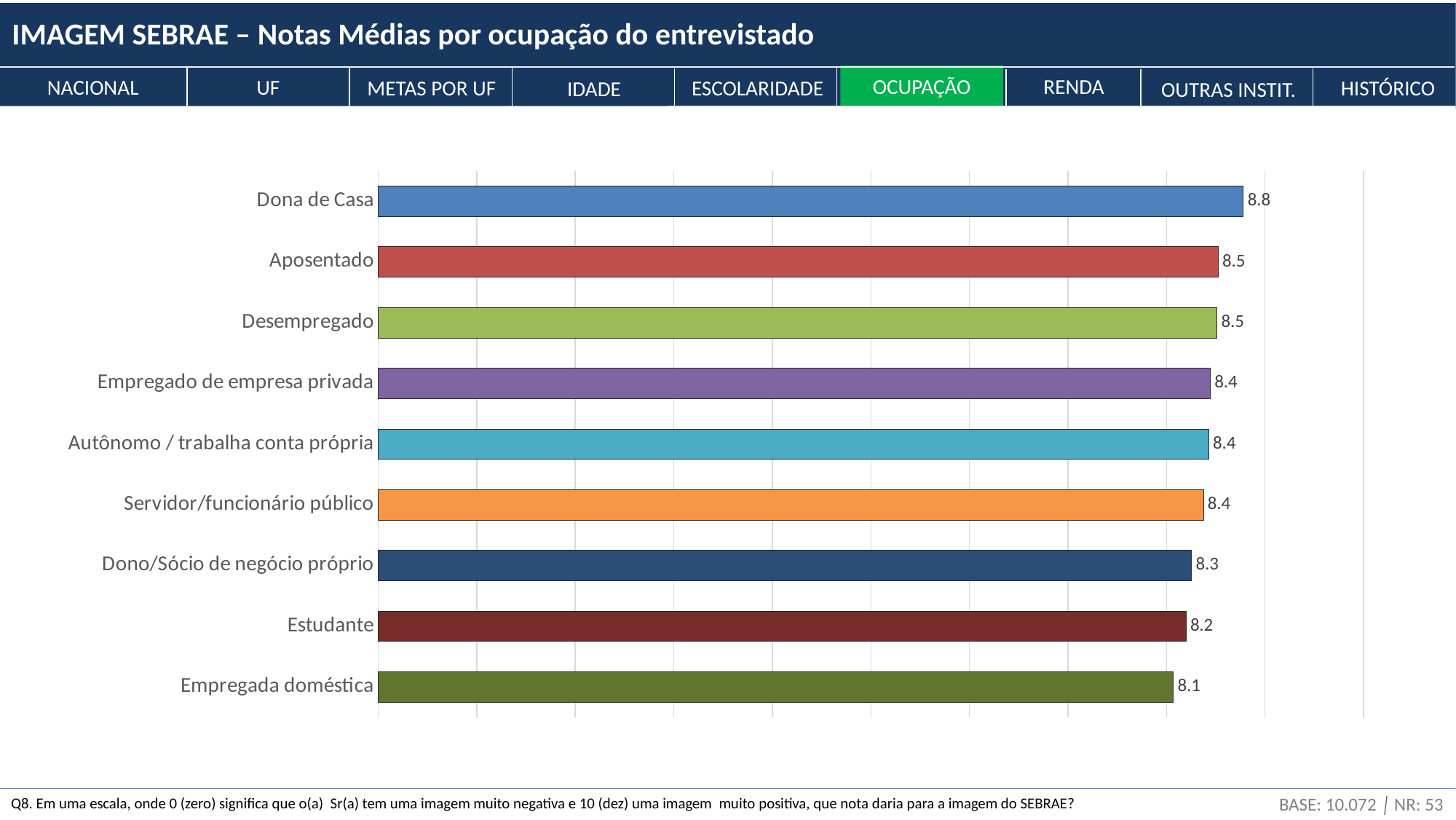
How many occupation categories are shown in the chart? 9 Which occupation has the highest average score? Dona de Casa What is the average score for Servidor/funcionário público? 8.4 What is the average score for Empregada doméstica? 8.1 Which has a higher score, Aposentado or Estudante? Aposentado What is the average score for Dona de Casa? 8.8 What is the difference between the scores for Dona de Casa and Empregada doméstica? 0.7 What is the average score for Estudante? 8.2 Which occupation has the lowest average score? Empregada doméstica What type of chart is shown on the slide? Bar chart Which tab is highlighted in green in the navigation bar? OCUPAÇÃO What is the difference between the scores for Aposentado and Dono/Sócio de negócio próprio? 0.2